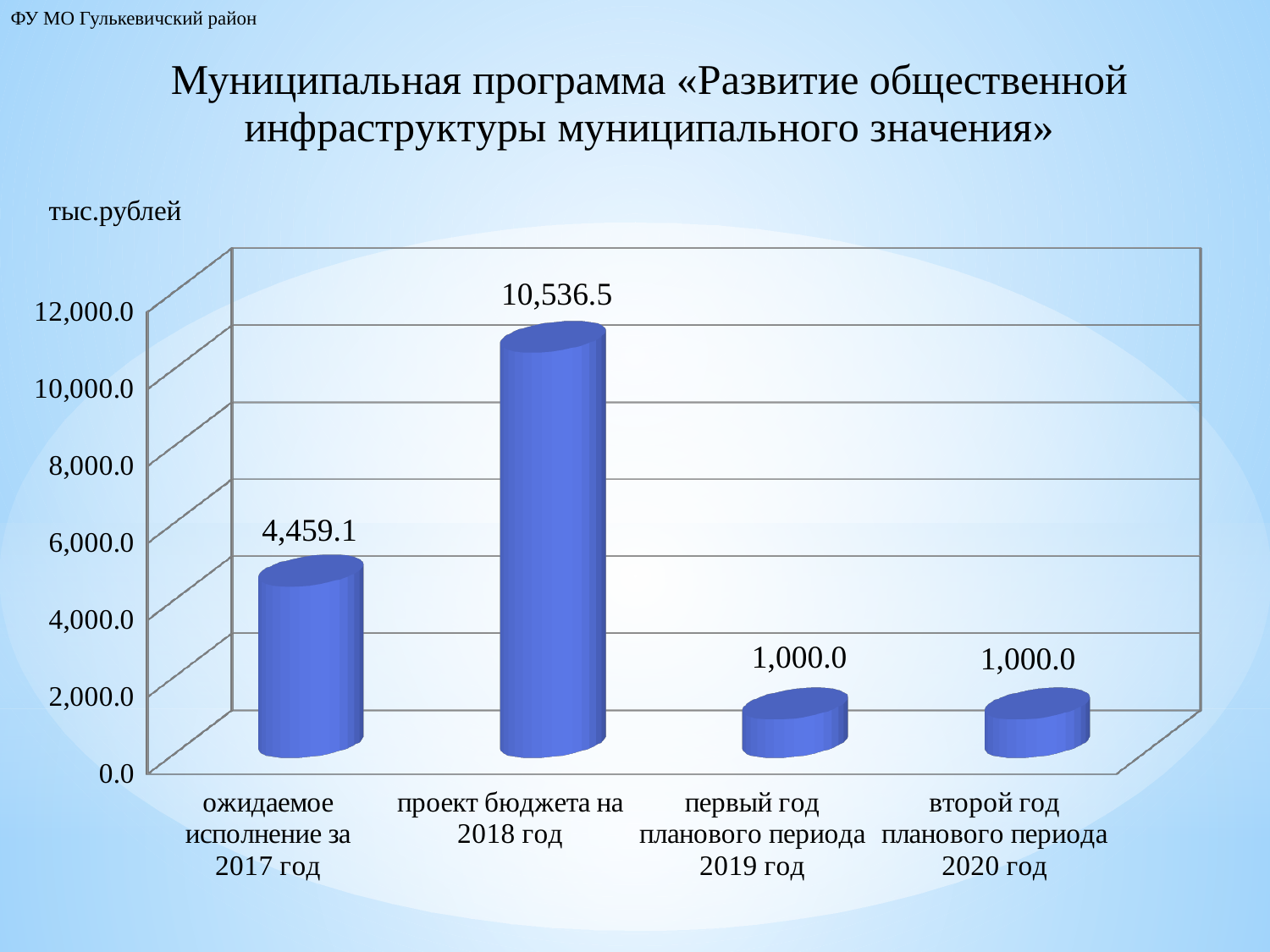
What kind of chart is shown on the slide? bar chart Is the value for 'проект бюджета на 2018 год' greater or less than 10,000.0? greater What is the value for 'проект бюджета на 2018 год'? 10,536.5 What is the total of the values for 'первый год планового периода 2019 год' and 'второй год планового периода 2020 год'? 2,000.0 What is the value for 'первый год планового периода 2019 год'? 1,000.0 How many categories are shown on the x axis? 4 Which is larger: the value for 'ожидаемое исполнение за 2017 год' or the value for 'проект бюджета на 2018 год'? проект бюджета на 2018 год What is the difference between the values for 'проект бюджета на 2018 год' and 'ожидаемое исполнение за 2017 год'? 6,077.4 What is the difference between the values for 'ожидаемое исполнение за 2017 год' and 'второй год планового периода 2020 год'? 3,459.1 What unit is indicated above the chart's vertical axis? тыс.рублей Which category has the highest value? проект бюджета на 2018 год What is the value for 'ожидаемое исполнение за 2017 год'? 4,459.1